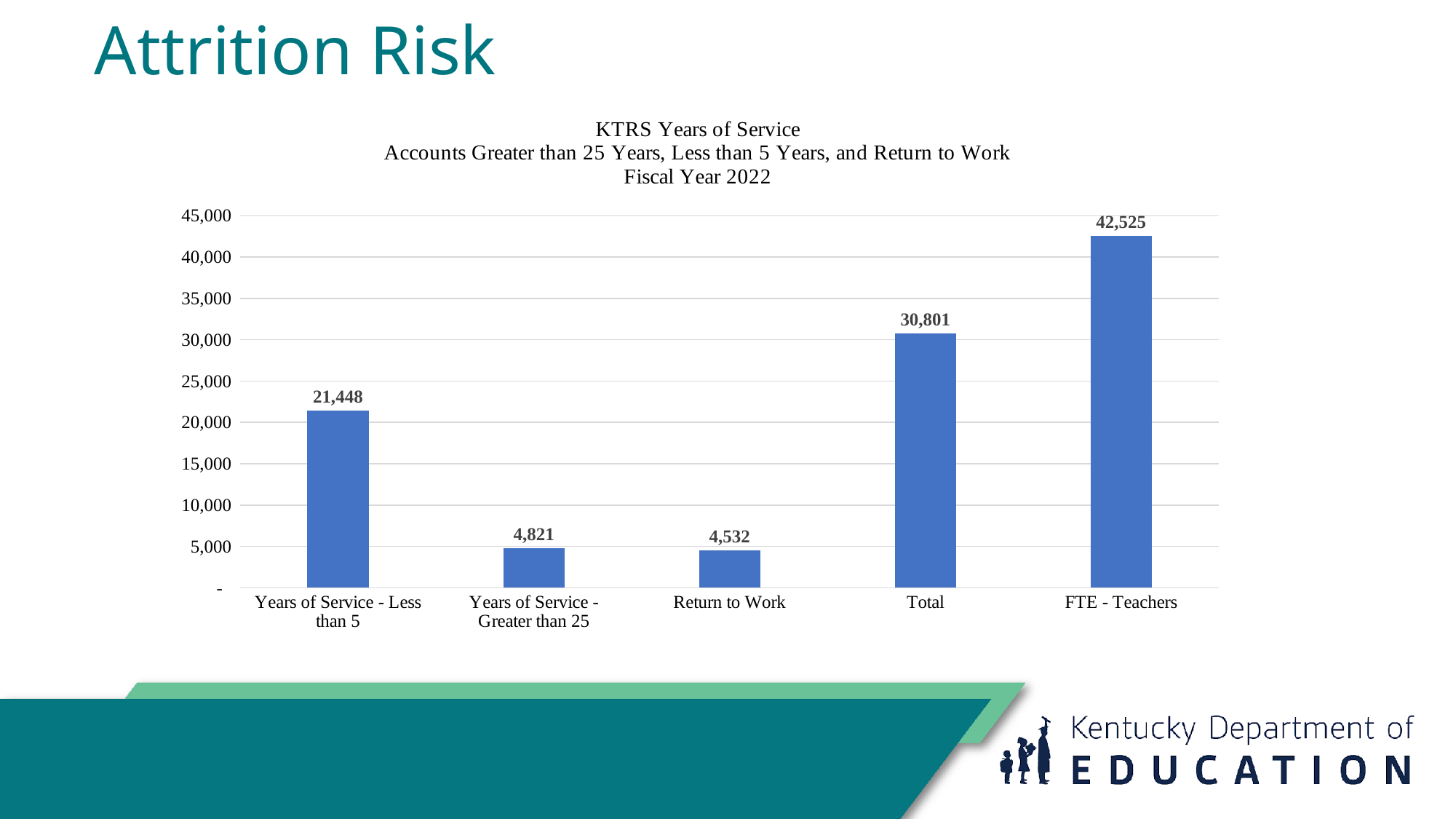
What is the value for Years of Service - Less than 5? 21,448 Which category has the highest value? FTE - Teachers What is the difference between Years of Service - Greater than 25 and Return to Work? 289 Which fiscal year does the chart title say the data is for? Fiscal Year 2022 What is the value for Return to Work? 4,532 What is the value for FTE - Teachers? 42,525 What kind of chart is shown on the slide? bar chart Which is larger, Years of Service - Less than 5 or Total? Total Is the value for Years of Service - Less than 5 greater or less than 20,000? greater What is the difference between the Total bar and the FTE - Teachers bar? 11,724 How many categories are shown on the x axis? 5 Which category has the lowest value? Return to Work